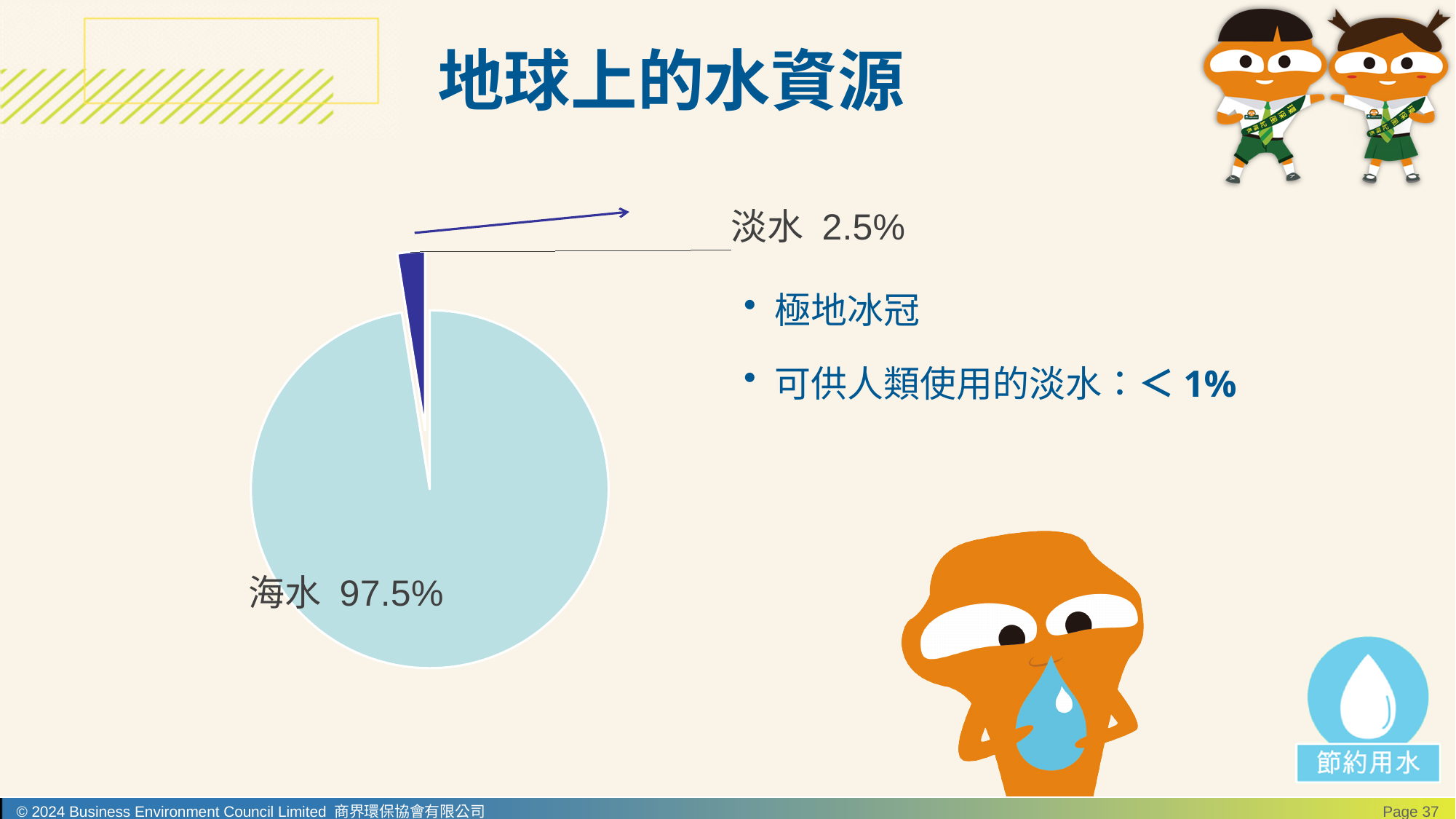
What colour is the 淡水 slice of the pie chart? dark blue What percentage does the 淡水 slice represent? 2.5% What is the difference between the 海水 share and the 淡水 share? 95% Which slice of the pie is the smallest? 淡水 Which slice of the pie is the largest? 海水 How many slices does the pie chart have? 2 What is the title of the slide containing the pie chart? 地球上的水資源 Which is larger, the 海水 slice or the 淡水 slice? 海水 What is the total of the two slices shown in the pie chart? 100% What kind of chart is shown on the slide? pie chart What percentage does the 海水 slice represent? 97.5%